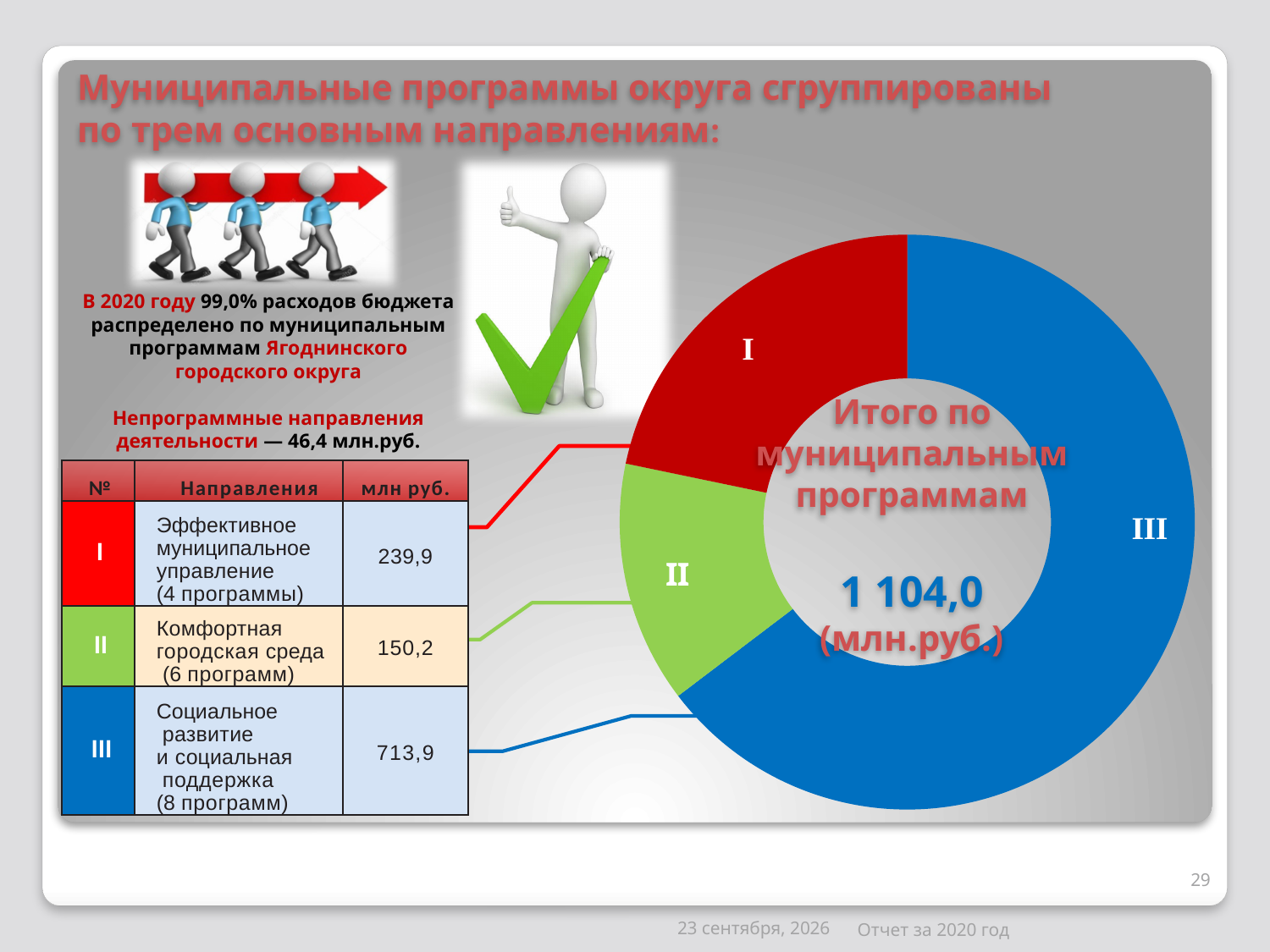
What is the value for segment II (Комфортная городская среда) in млн руб.? 150,2 What type of chart is shown on the slide? Doughnut (ring) chart What colour is segment III in the doughnut chart? Blue What is the value for segment I (Эффективное муниципальное управление) in млн руб.? 239,9 What is the total shown in the centre of the doughnut chart (млн руб.)? 1 104,0 Which segment of the doughnut chart is the smallest? II What is the difference between the values for segment III and segment I (млн руб.)? 474,0 What is the value for segment III (Социальное развитие и социальная поддержка) in млн руб.? 713,9 What colour is segment I in the doughnut chart? Red How many segments does the doughnut chart have? 3 Which is larger, the value for segment I or segment II? Segment I Which segment of the doughnut chart is the largest? III